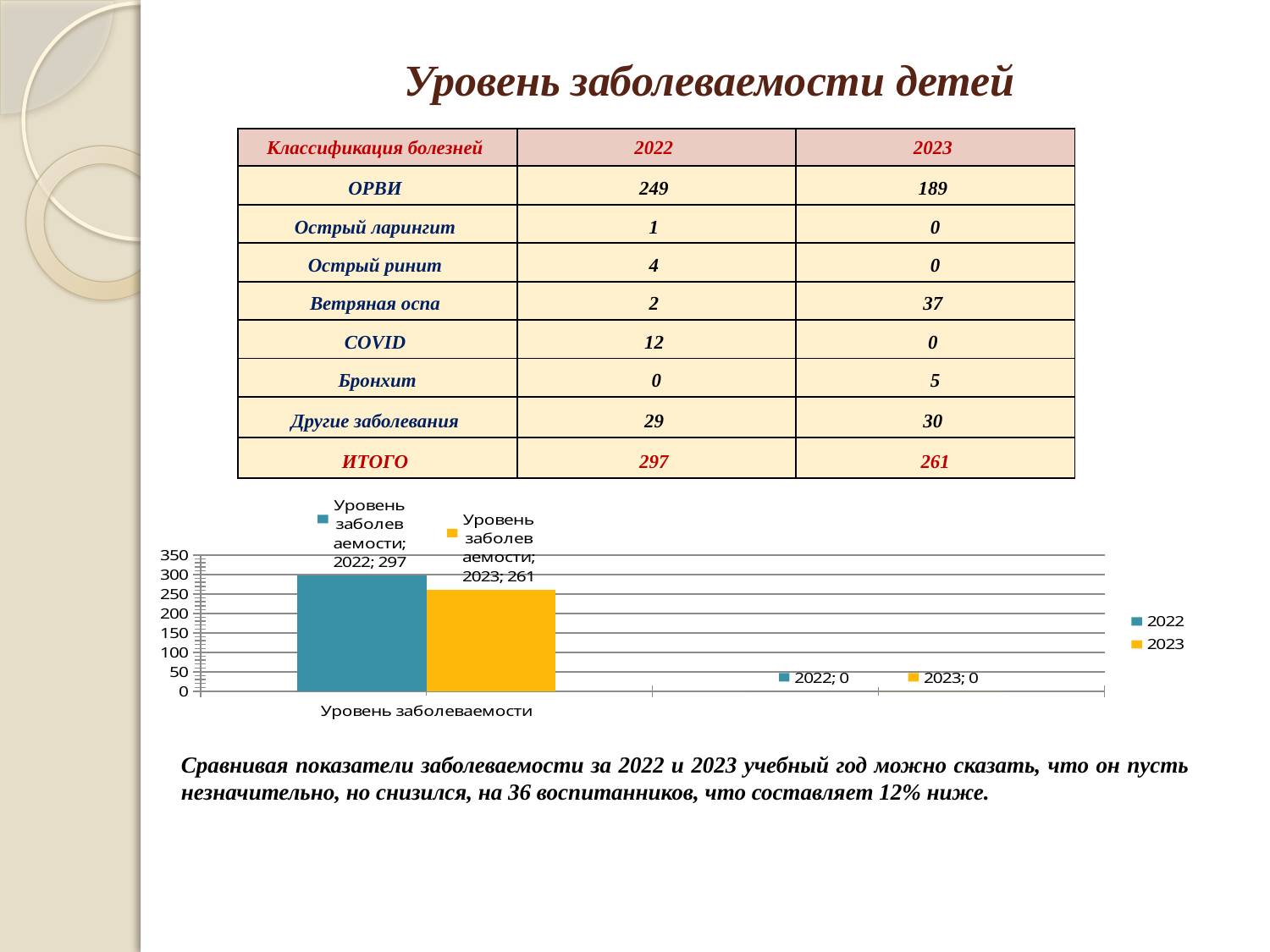
What is the category label shown under the bars on the chart's horizontal axis? Уровень заболеваемости How many series does the chart legend list? 2 In the chart, what is the difference between the 2022 and 2023 values for Уровень заболеваемости? 36 In the chart, what is the value for 2023 for Уровень заболеваемости? 261 What is the highest value shown on the chart's vertical axis? 350 In the chart, is the value for 2023 greater or less than 300? less In the chart, which series has the higher value for Уровень заболеваемости, 2022 or 2023? 2022 In the chart, what is the value for 2022 for Уровень заболеваемости? 297 What type of chart is shown on the slide? bar chart In the chart, which series has the lowest value for Уровень заболеваемости? 2023 In the chart, is the value for 2022 greater or less than 250? greater